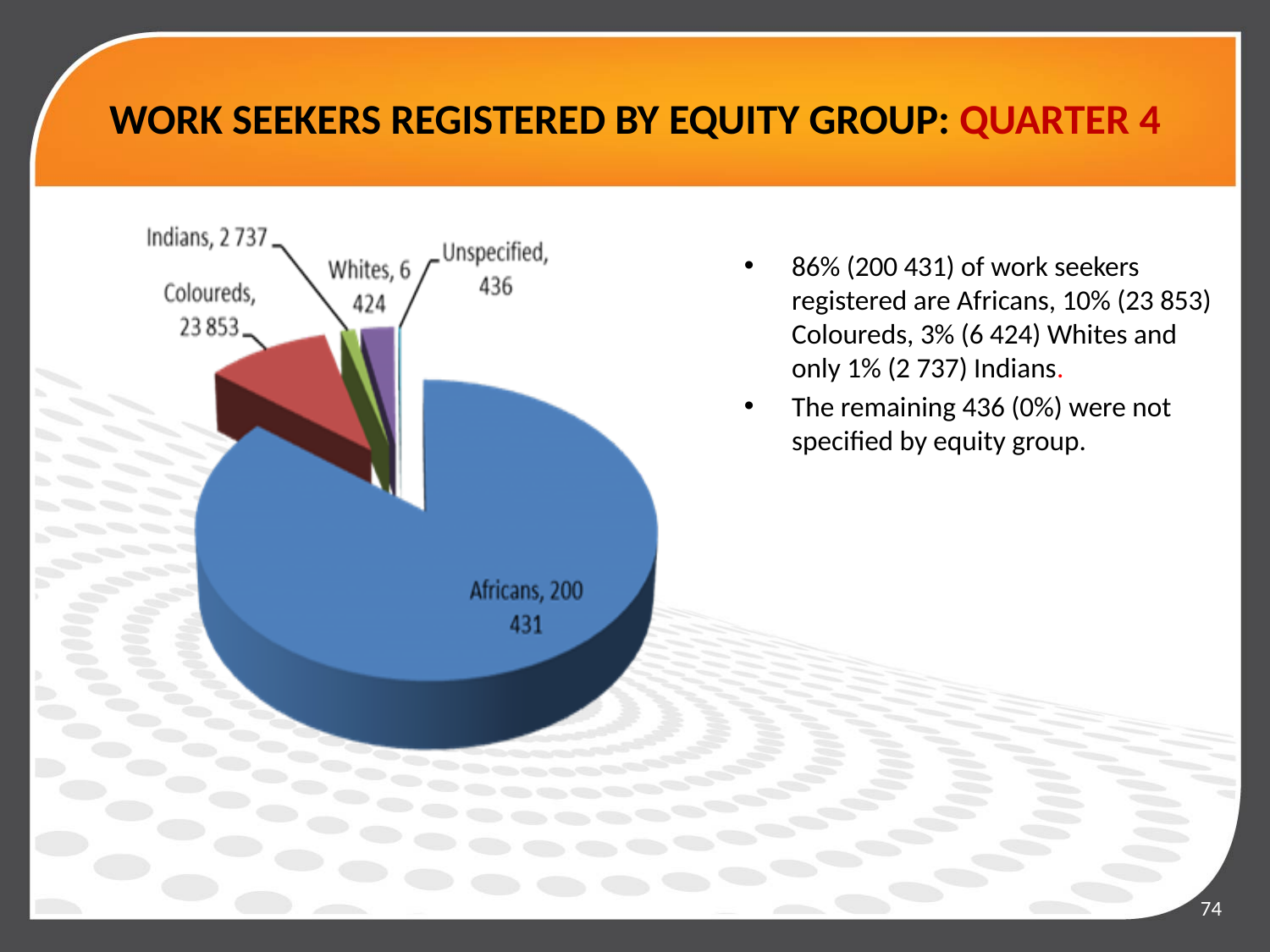
What is the value shown for Unspecified in the pie chart? 436 Which equity group has the largest slice in the pie chart? Africans What share of registered work seekers are Africans, according to the slide? 86% Which equity group has the smallest slice in the pie chart? Unspecified What kind of chart is shown on the slide? pie chart What is the value shown for Coloureds in the pie chart? 23 853 What is the value shown for Indians in the pie chart? 2 737 What is the value shown for Africans in the pie chart? 200 431 What is the difference between the values for Coloureds and Whites in the pie chart? 17 429 How many slices does the pie chart have? 5 What is the value shown for Whites in the pie chart? 6 424 Which is larger in the pie chart, the value for Whites or the value for Indians? Whites